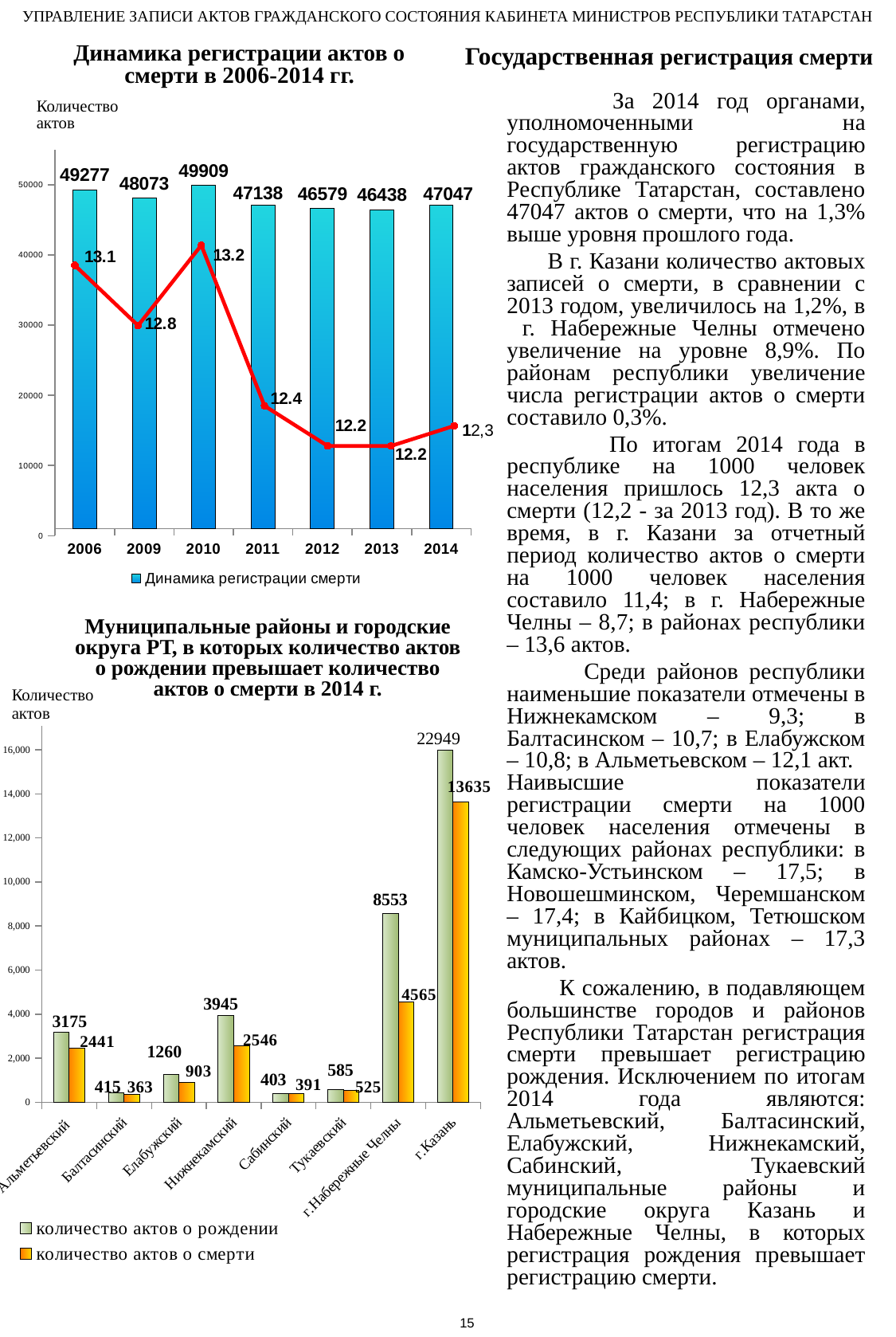
In the bottom chart about municipal districts and city districts, how many series does the legend list? 2 In the chart 'Динамика регистрации актов о смерти в 2006-2014 гг.', how many years are shown on the x axis? 7 In the chart 'Динамика регистрации актов о смерти в 2006-2014 гг.', which year has the lowest number of death acts? 2013 In the bottom chart about municipal districts and city districts, how many acts of birth were registered in г.Казань in 2014? 22949 In the chart 'Динамика регистрации актов о смерти в 2006-2014 гг.', what value does the red line show for 2011? 12.4 In the chart 'Динамика регистрации актов о смерти в 2006-2014 гг.', what is the number of death acts registered in 2014? 47047 In the chart 'Динамика регистрации актов о смерти в 2006-2014 гг.', what is the difference between the values for 2010 and 2009? 1836 In the chart 'Динамика регистрации актов о смерти в 2006-2014 гг.', what is the single legend entry? Динамика регистрации смерти In the bottom chart about municipal districts and city districts, how many acts of death were registered in Нижнекамский in 2014? 2546 In the chart 'Динамика регистрации актов о смерти в 2006-2014 гг.', which year has the highest number of death acts? 2010 In the bottom chart about municipal districts and city districts, what is the difference between acts of birth and acts of death in г.Набережные Челны? 3988 In the bottom chart about municipal districts and city districts, how many districts/cities are shown on the x axis? 8